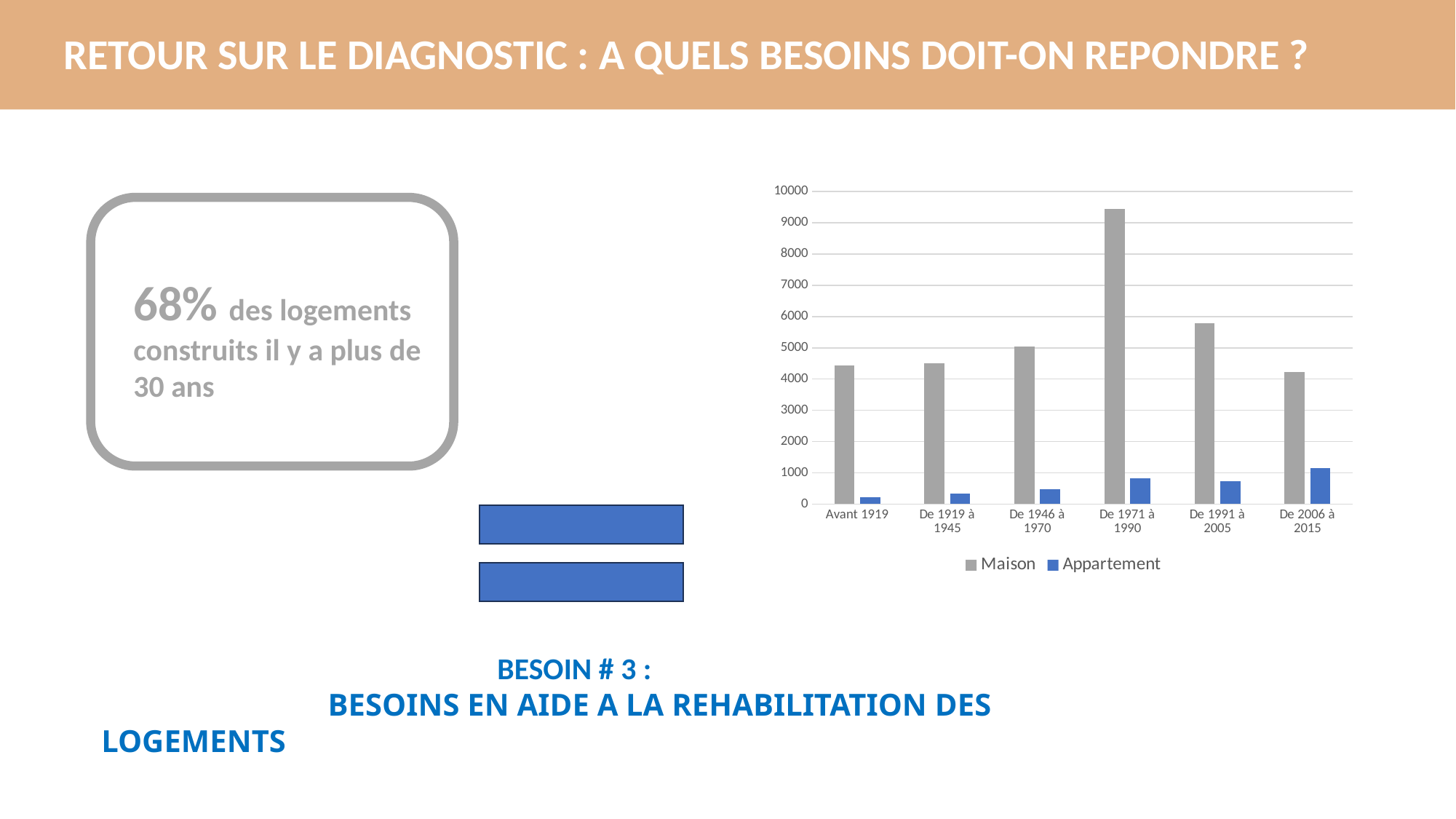
Which construction period has the highest value for Appartement? De 2006 à 2015 Which construction period has the highest value for Maison? De 1971 à 1990 How many construction-period categories are shown on the x axis of the chart? 6 Is the Appartement value for De 1971 à 1990 greater or less than 1000? less Is the Maison value for De 1991 à 2005 greater or less than 5000? greater How many series does the chart legend list? 2 Is the Appartement value for De 2006 à 2015 greater or less than 1000? greater What kind of chart is shown on the slide? bar chart What are the two series named in the chart legend? Maison and Appartement Which is larger, the Maison value for De 1991 à 2005 or the Maison value for De 1946 à 1970? De 1991 à 2005 Which construction period has the lowest value for Appartement? Avant 1919